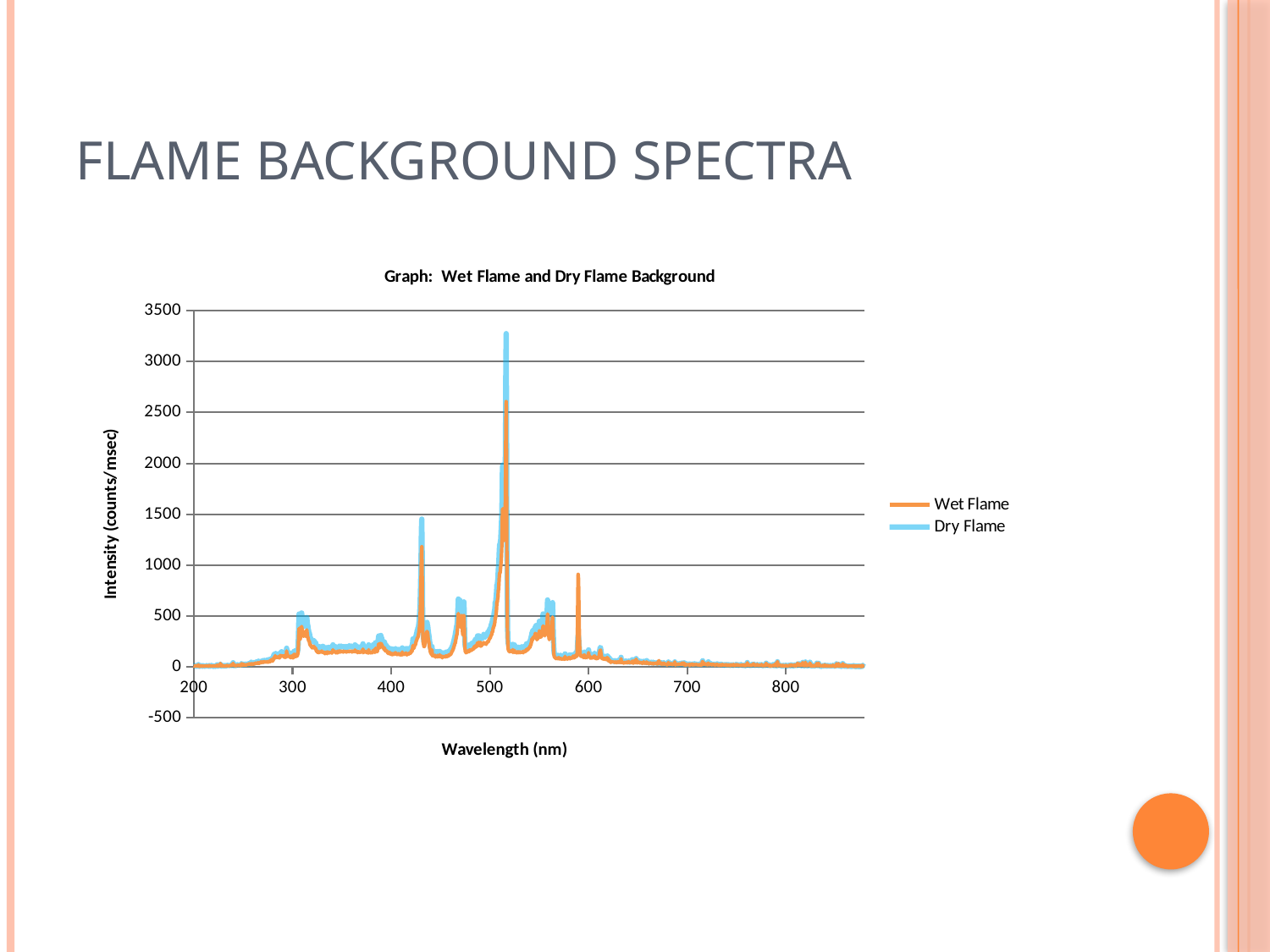
Is the highest peak of the Dry Flame series greater or less than 3000? greater How many series does the legend list? 2 What kind of chart is shown on the slide? line chart At the tallest peak near 515 nm, which series has the larger intensity, Wet Flame or Dry Flame? Dry Flame Is the highest peak of the Wet Flame series greater or less than 2000? greater What is the title of the chart? Graph: Wet Flame and Dry Flame Background Which series reaches the highest intensity anywhere on the chart? Dry Flame What is the label of the y axis? Intensity (counts/msec) Is the Dry Flame peak near 430 nm greater or less than 1000? greater At the sharp peak near 590 nm, which series has the larger intensity, Wet Flame or Dry Flame? Wet Flame